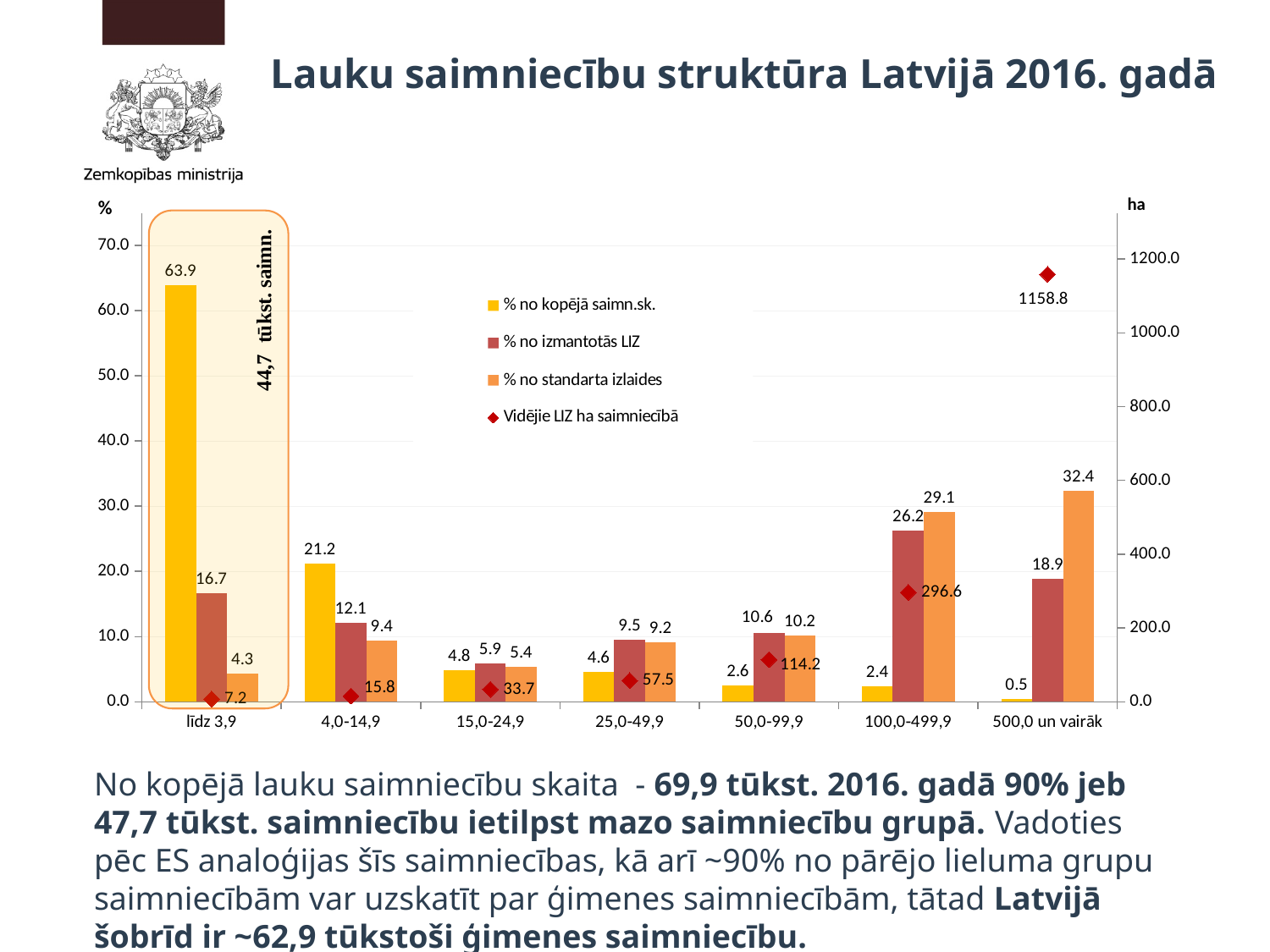
Which is larger: "% no standarta izlaides" for "500,0 un vairāk" or for "100,0-499,9"? 500,0 un vairāk Which category has the lowest value for "% no kopējā saimn.sk."? 500,0 un vairāk What is the value of "% no kopējā saimn.sk." for the "līdz 3,9" category? 63.9 What is the value of "% no standarta izlaides" for the "100,0-499,9" category? 29.1 Which category has the highest value for "% no izmantotās LIZ"? 100,0-499,9 What is the value of "Vidējie LIZ ha saimniecībā" for the "500,0 un vairāk" category? 1158.8 What kind of chart is shown on the slide? Bar chart with a marker series What is the title of the chart? Lauku saimniecību struktūra Latvijā 2016. gadā How many size categories are shown on the x axis? 7 How many series does the legend list? 4 What is the difference between the "% no kopējā saimn.sk." values for "līdz 3,9" and "4,0-14,9"? 42.7 Does the "Vidējie LIZ ha saimniecībā" series rise or fall from left to right along the x axis? Rise